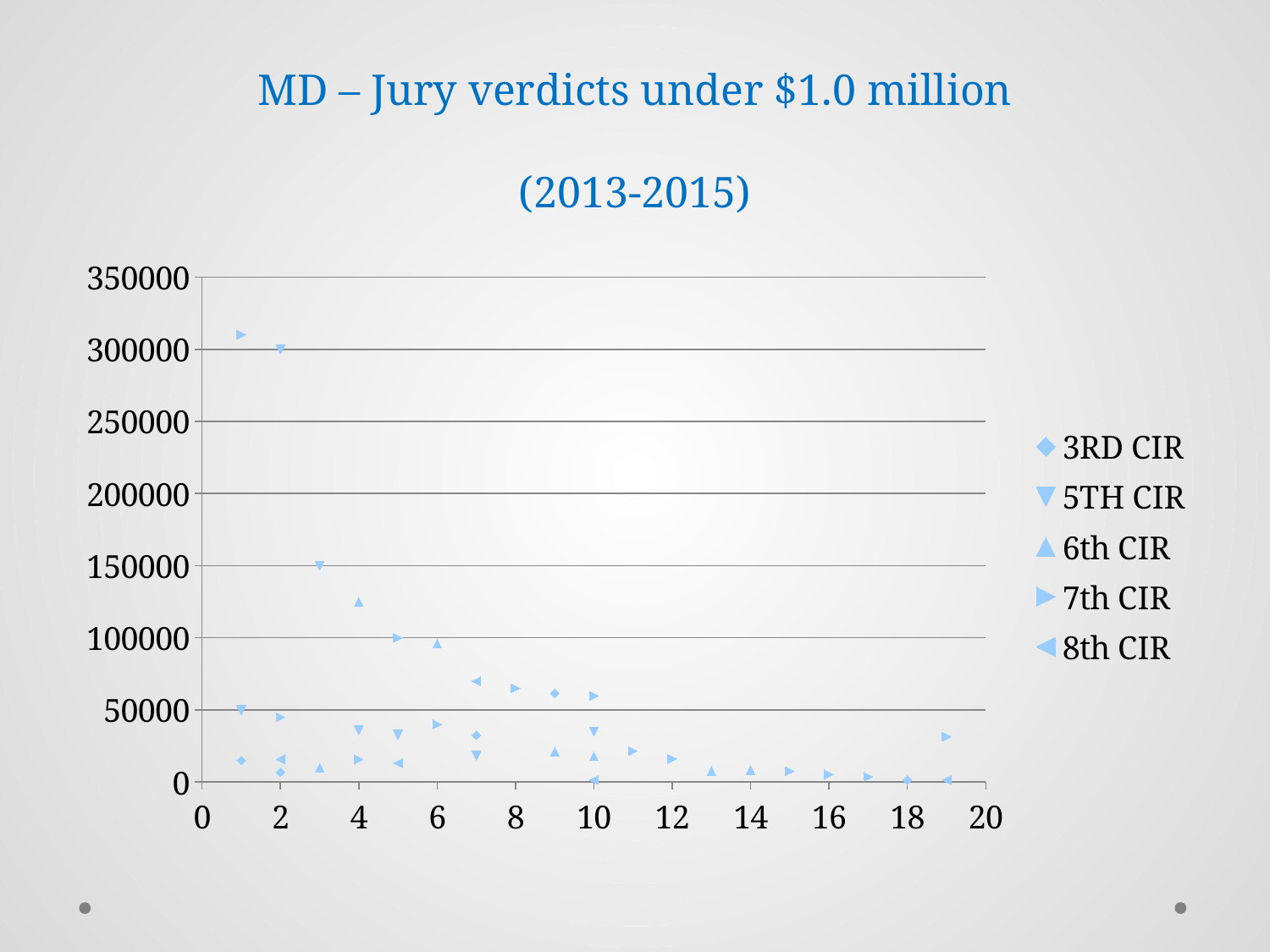
How many series does the legend list? 5 Is the value of the 5TH CIR point at x = 1 greater or less than 100000? less Is the value of the 7th CIR point at x = 1 greater or less than 250000? greater Do the plotted values generally rise or fall as the x value increases? fall What is the title of the chart? MD – Jury verdicts under $1.0 million (2013-2015) Is the value of the 7th CIR point at x = 19 greater or less than 50000? less What is the highest value shown on the vertical axis? 350000 What kind of chart is shown on the slide? scatter chart Which series is shown with a diamond marker in the legend? 3RD CIR Which series has the highest plotted point on the chart? 7th CIR